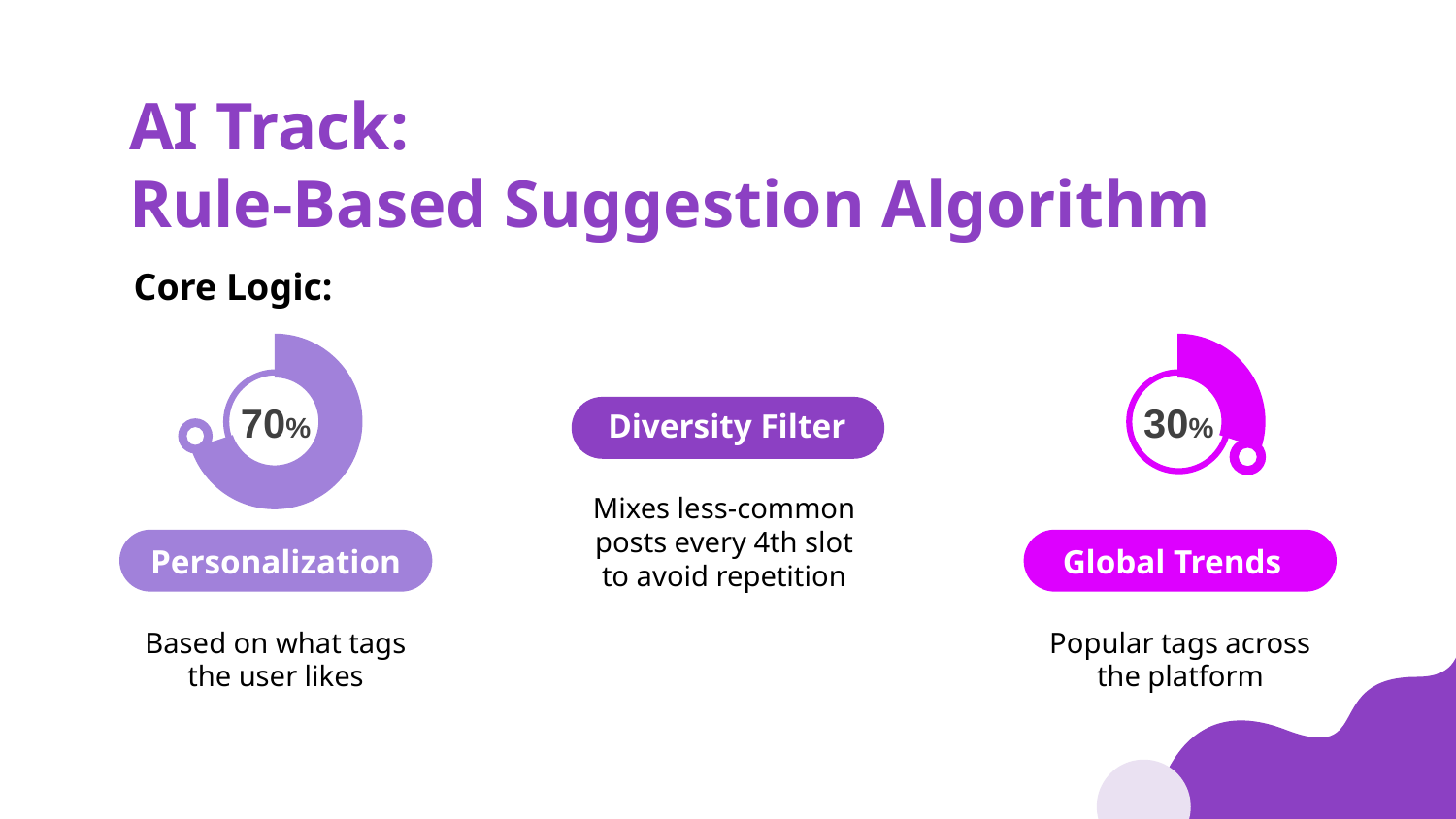
Which of the two donut charts shows the higher value? Personalization What is the difference between the Personalization percentage and the Global Trends percentage? 40% How many donut charts are on the slide? 2 What percentage is shown in the Global Trends donut chart on the right? 30% What kind of chart is used to show the Personalization value? Donut chart What percentage is shown in the Personalization donut chart on the left? 70% Is the value in the Global Trends donut chart greater or less than 50%? less Is the value in the Personalization donut chart greater or less than 50%? greater Which of the three core logic items has no donut chart? Diversity Filter What colour is the Global Trends donut chart? Magenta Which of the two donut charts shows the lower value? Global Trends Which is larger, the Personalization value or the Global Trends value? Personalization